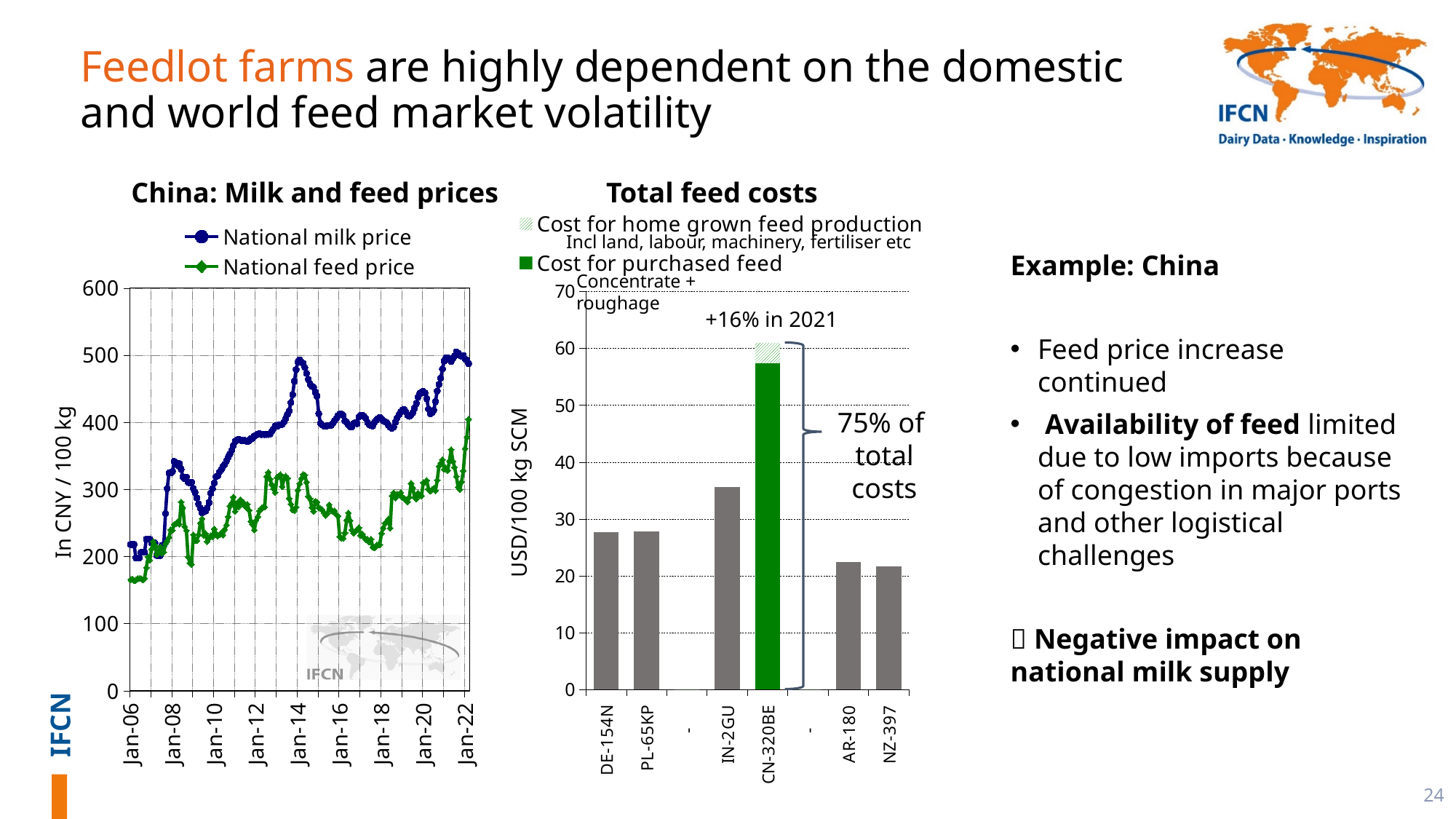
In the 'China: Milk and feed prices' chart, is the National milk price at Jan-22 greater or less than 400? greater In the 'Total feed costs' chart, is the value for AR-180 greater or less than 30? less In the 'Total feed costs' chart, what annotation is printed above the CN-320BE bar? +16% in 2021 What kind of chart is the 'China: Milk and feed prices' chart? line chart In the 'Total feed costs' chart, how many farms are shown as bars? 6 In the 'China: Milk and feed prices' chart, does the National milk price overall rise or fall from Jan-06 to Jan-22? rise In the 'Total feed costs' chart, which farm has the highest total feed cost? CN-320BE In the 'China: Milk and feed prices' chart, which series is higher at Jan-22, National milk price or National feed price? National milk price In the 'Total feed costs' chart, is the value for IN-2GU greater or less than 30? greater What kind of chart is the 'Total feed costs' chart? bar chart In the 'China: Milk and feed prices' chart, how many series does the legend list? 2